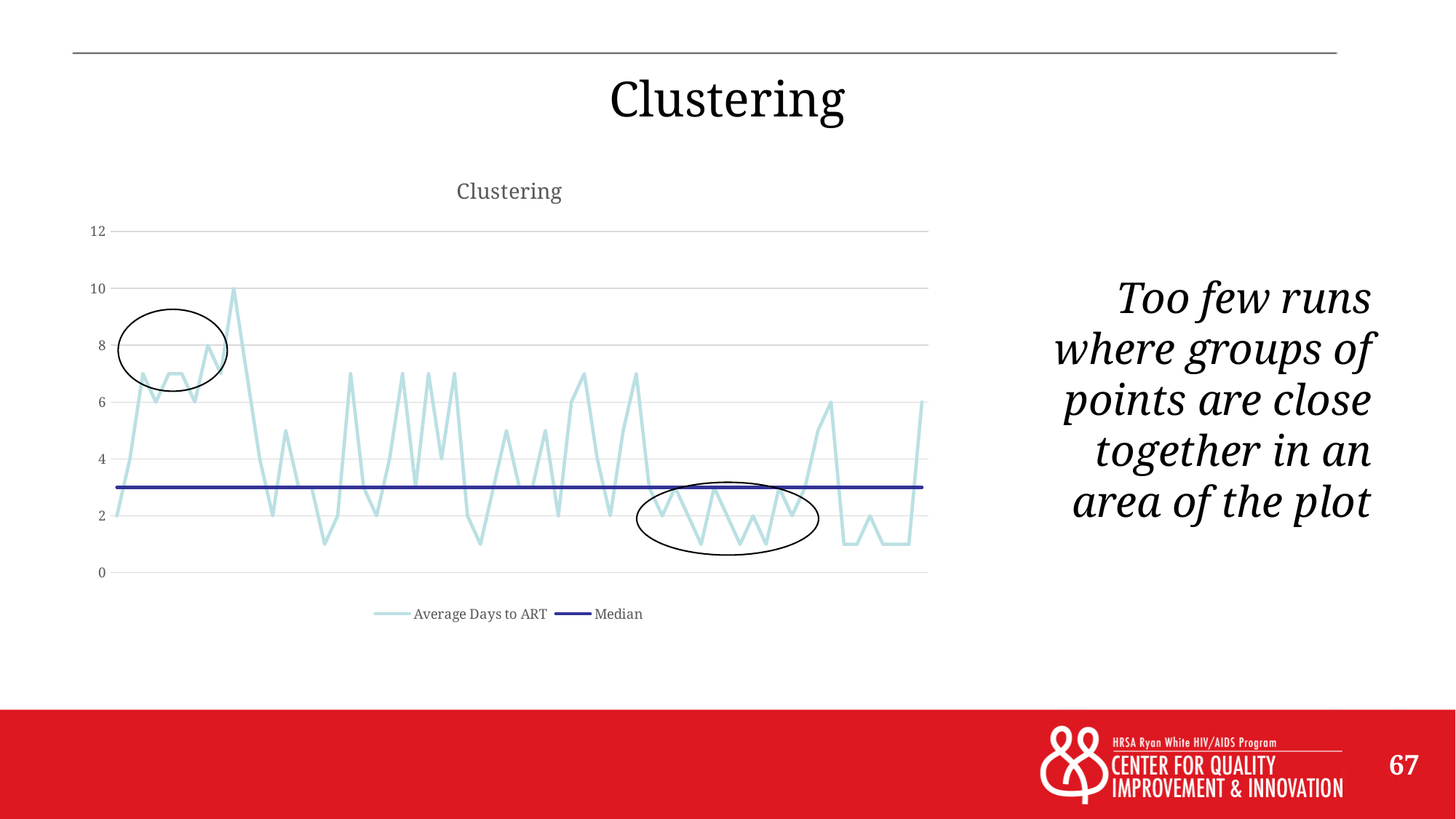
Does the Median line rise, fall, or stay flat across the chart? stay flat Is the Median line greater or less than 4? less How many series does the legend list? 2 Which series reaches the higher maximum value, Average Days to ART or Median? Average Days to ART What type of chart is shown on the slide? line chart What are the two series named in the legend? Average Days to ART and Median What is the highest value reached by the Average Days to ART line? 10 Is the lowest value of the Average Days to ART line greater or less than 2? less Is the first point of the Average Days to ART line above or below the Median line? below What is the title of the chart? Clustering Is the peak of the Average Days to ART line greater or less than 8? greater